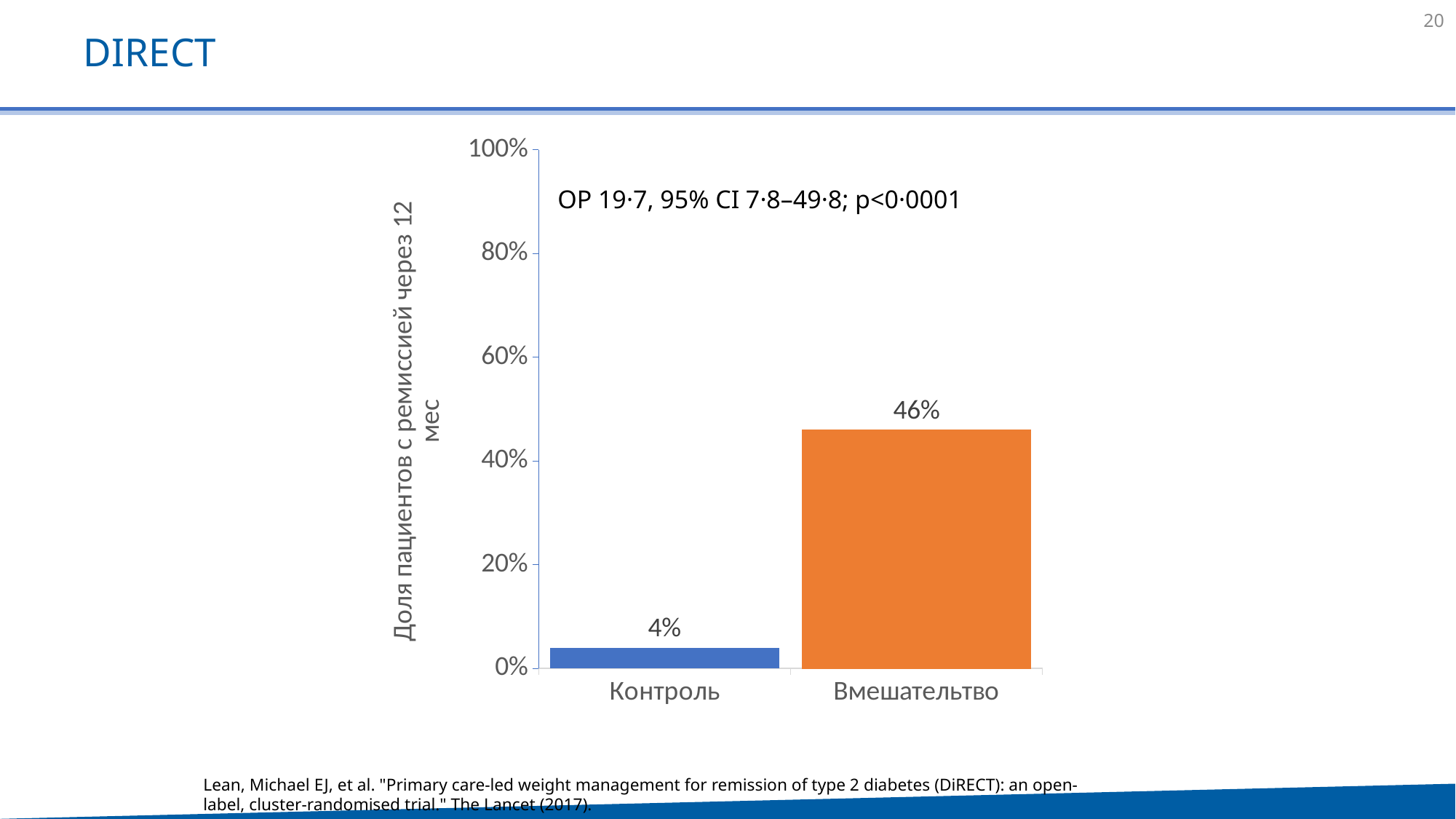
Which category has the highest value? Вмешательство Is the value for Контроль greater or less than 20%? less What is the difference between the values for Вмешательство and Контроль? 42% What colour is the bar for Вмешательство? orange What is the label of the y axis? Доля пациентов с ремиссией через 12 мес How many categories are shown on the x axis? 2 Is the value for Вмешательство greater or less than 40%? greater What is the value for Контроль? 4% What kind of chart is shown on the slide? bar chart What is the value for Вмешательство? 46% Which is larger, the value for Контроль or the value for Вмешательство? Вмешательство Which category has the lowest value? Контроль